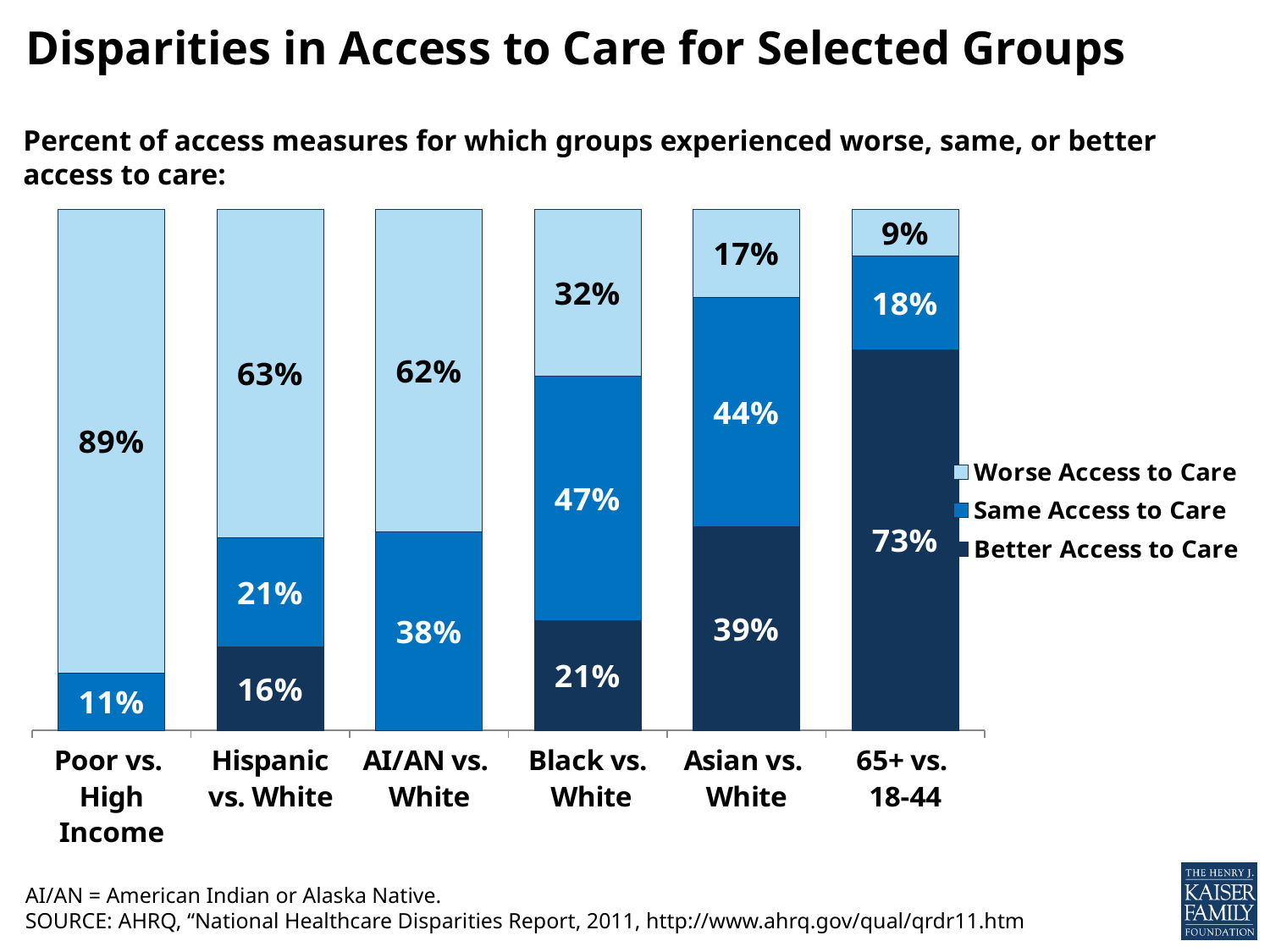
Which group has the lowest percent of access measures with worse access to care? 65+ vs. 18-44 What is the total of the Asian vs. White stacked bar? 100% Which is larger: the better access to care share for Asian vs. White or for Black vs. White? Asian vs. White What kind of chart is shown on the slide? Stacked bar chart What percent of access measures showed same access to care for AI/AN vs. White? 38% What percent of access measures showed same access to care for Black vs. White? 47% How many series does the legend list? 3 How many groups are shown on the x axis? 6 What percent of access measures showed worse access to care for Poor vs. High Income? 89% What is the difference between the worse access to care percentages for Hispanic vs. White and Black vs. White? 31% Which group has the highest percent of access measures with worse access to care? Poor vs. High Income What percent of access measures showed better access to care for 65+ vs. 18-44? 73%